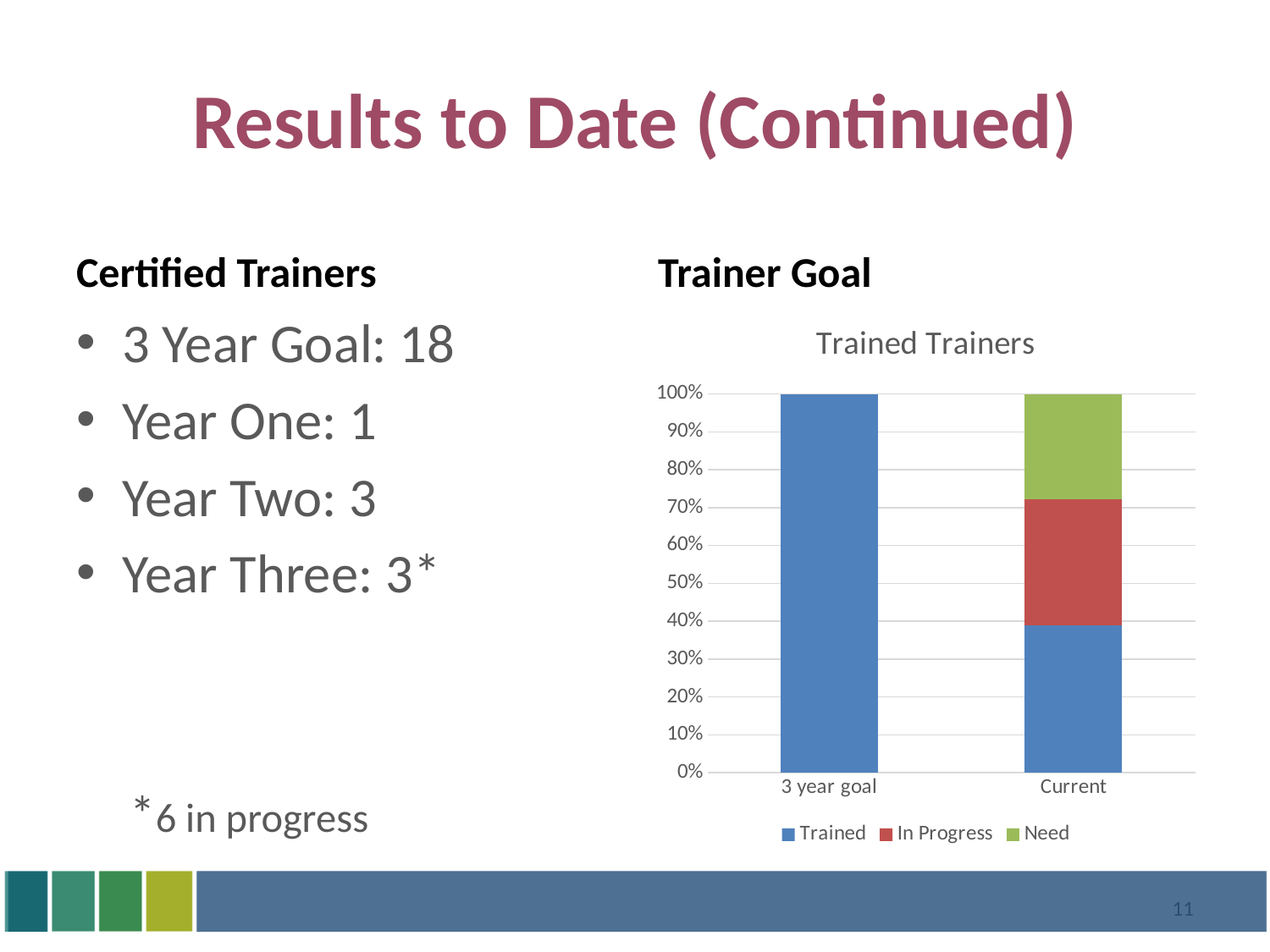
Is the Trained value for Current greater or less than 30%? greater Which category's bar contains only the Trained series? 3 year goal What is the title of the chart? Trained Trainers Which category has the larger Trained share, 3 year goal or Current? 3 year goal Which series is shown in green in the chart legend? Need How many series does the chart legend list? 3 Is the top of the In Progress segment for Current greater or less than 80%? less What type of chart is shown on the slide? stacked bar chart Is the Trained value for Current greater or less than 50%? less How many categories are shown on the x axis of the chart? 2 What percentage does the Trained segment reach for the 3 year goal bar? 100% Which category's bar includes a Need segment? Current